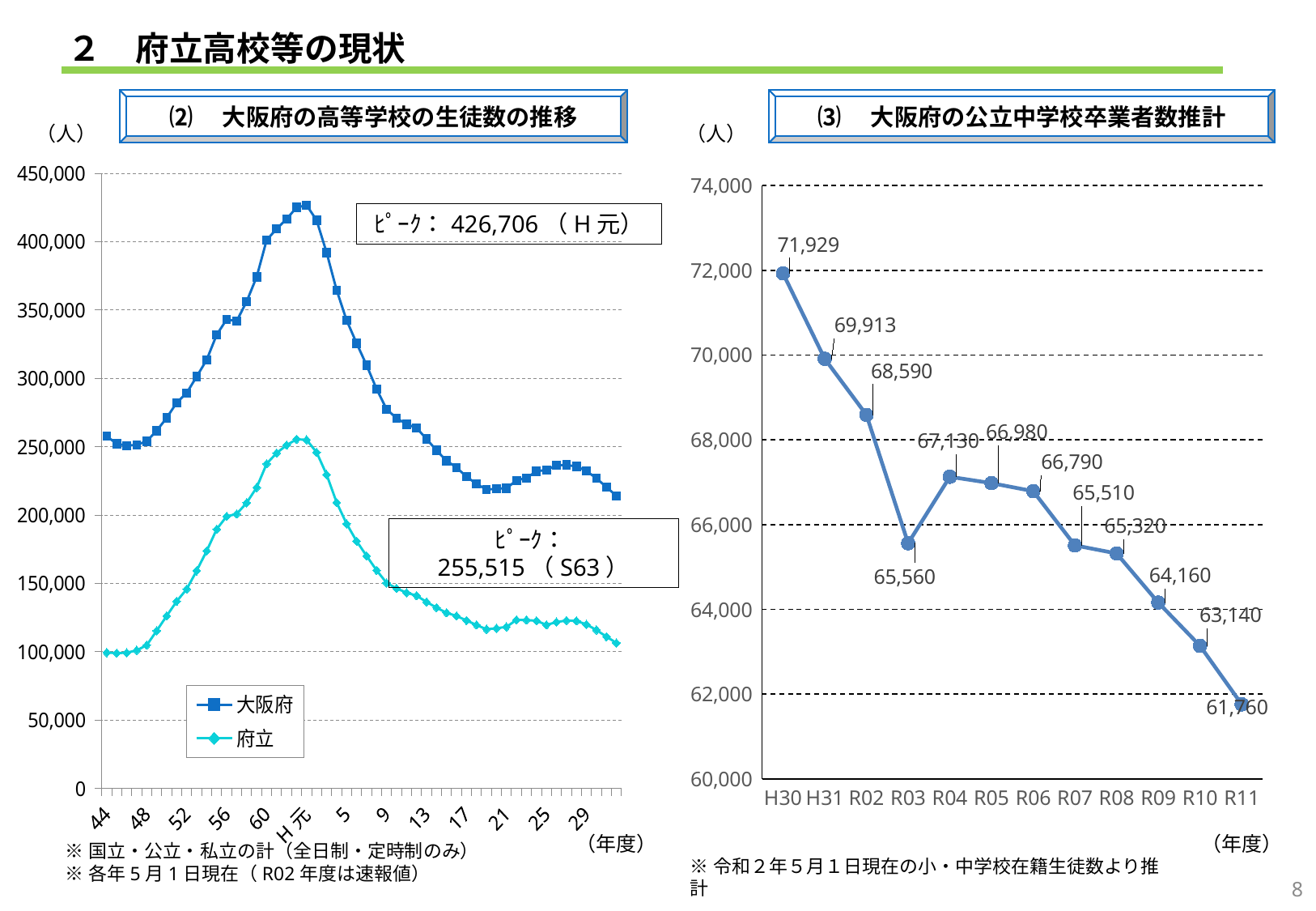
In the chart titled (3) 大阪府の公立中学校卒業者数推計, what is the difference between the values for H30 and H31? 2,016 In the chart titled (3) 大阪府の公立中学校卒業者数推計, how many years are plotted on the x axis? 12 In the chart titled (2) 大阪府の高等学校の生徒数の推移, what is the peak value of the 大阪府 series according to the annotation? 426,706 In the chart titled (2) 大阪府の高等学校の生徒数の推移, what is the peak value of the 府立 series according to the annotation? 255,515 In the chart titled (3) 大阪府の公立中学校卒業者数推計, do the values generally rise or fall from H30 to R11? fall In the chart titled (3) 大阪府の公立中学校卒業者数推計, what is the value for H30? 71,929 In the chart titled (2) 大阪府の高等学校の生徒数の推移, how many series does the legend list? 2 In the chart titled (3) 大阪府の公立中学校卒業者数推計, what is the value for R03? 65,560 In the chart titled (3) 大阪府の公立中学校卒業者数推計, what is the value for R11? 61,760 In the chart titled (3) 大阪府の公立中学校卒業者数推計, which is larger, the value for R04 or the value for R05? R04 In the chart titled (3) 大阪府の公立中学校卒業者数推計, which year has the lowest value? R11 In the chart titled (3) 大阪府の公立中学校卒業者数推計, which year has the highest value? H30